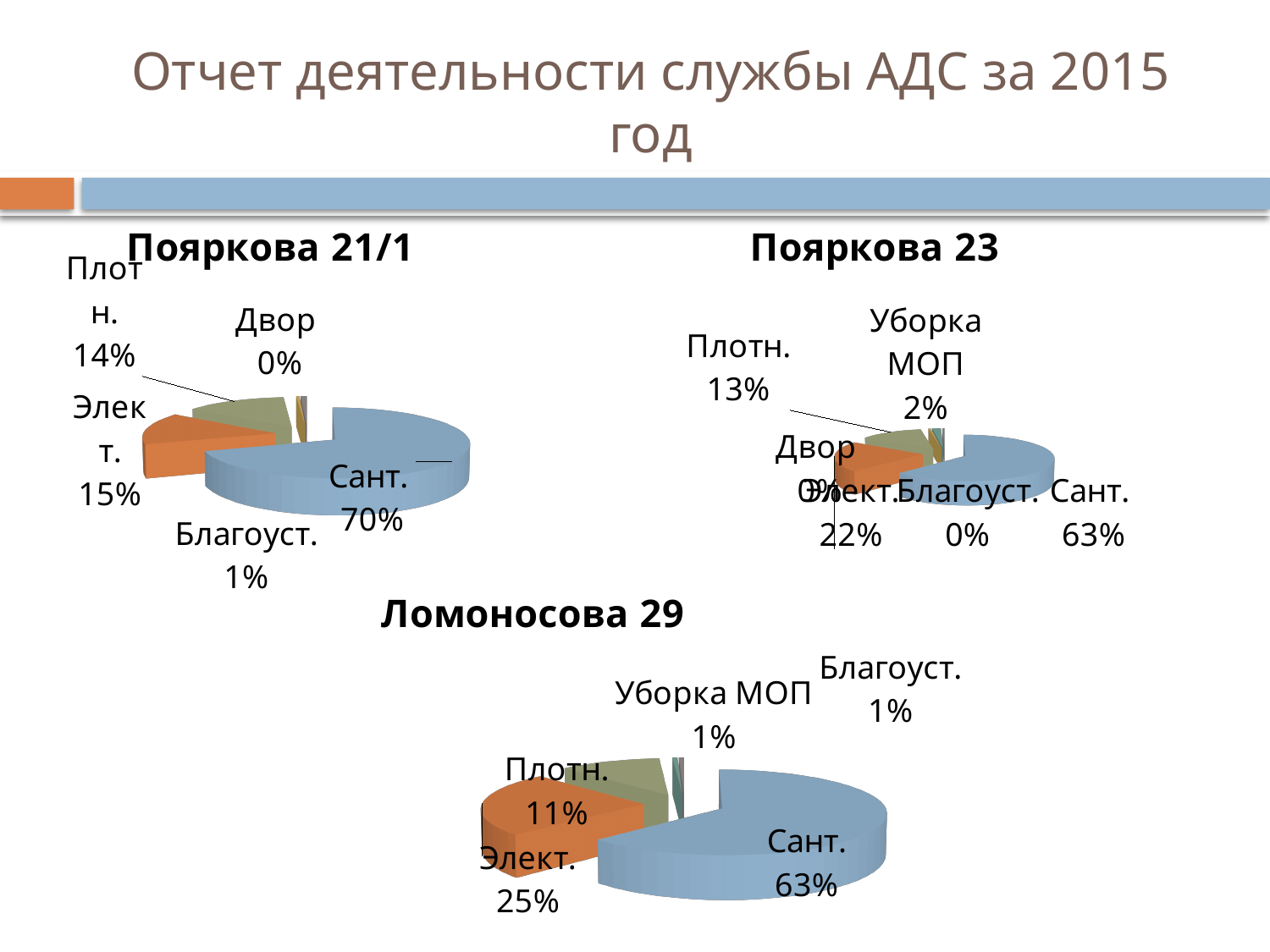
In the Пояркова 23 chart, what share does Плотн. have? 13% In the Ломоносова 29 chart, what is the difference between the shares of Сант. and Элект.? 38% In the Ломоносова 29 chart, what share does Сант. have? 63% In the Пояркова 23 chart, what share does Уборка МОП have? 2% In the Пояркова 21/1 chart, what share does Сант. have? 70% In the Пояркова 21/1 chart, which category has the largest share? Сант. What type of chart is the Ломоносова 29 chart? Pie chart In the Ломоносова 29 chart, which is larger, the share of Плотн. or the share of Элект.? Элект. In the Пояркова 21/1 chart, what share does Элект. have? 15% In the Пояркова 21/1 chart, what is the difference between the shares of Элект. and Плотн.? 1% In the Ломоносова 29 chart, what share does Элект. have? 25% In the Пояркова 23 chart, what share does Элект. have? 22%